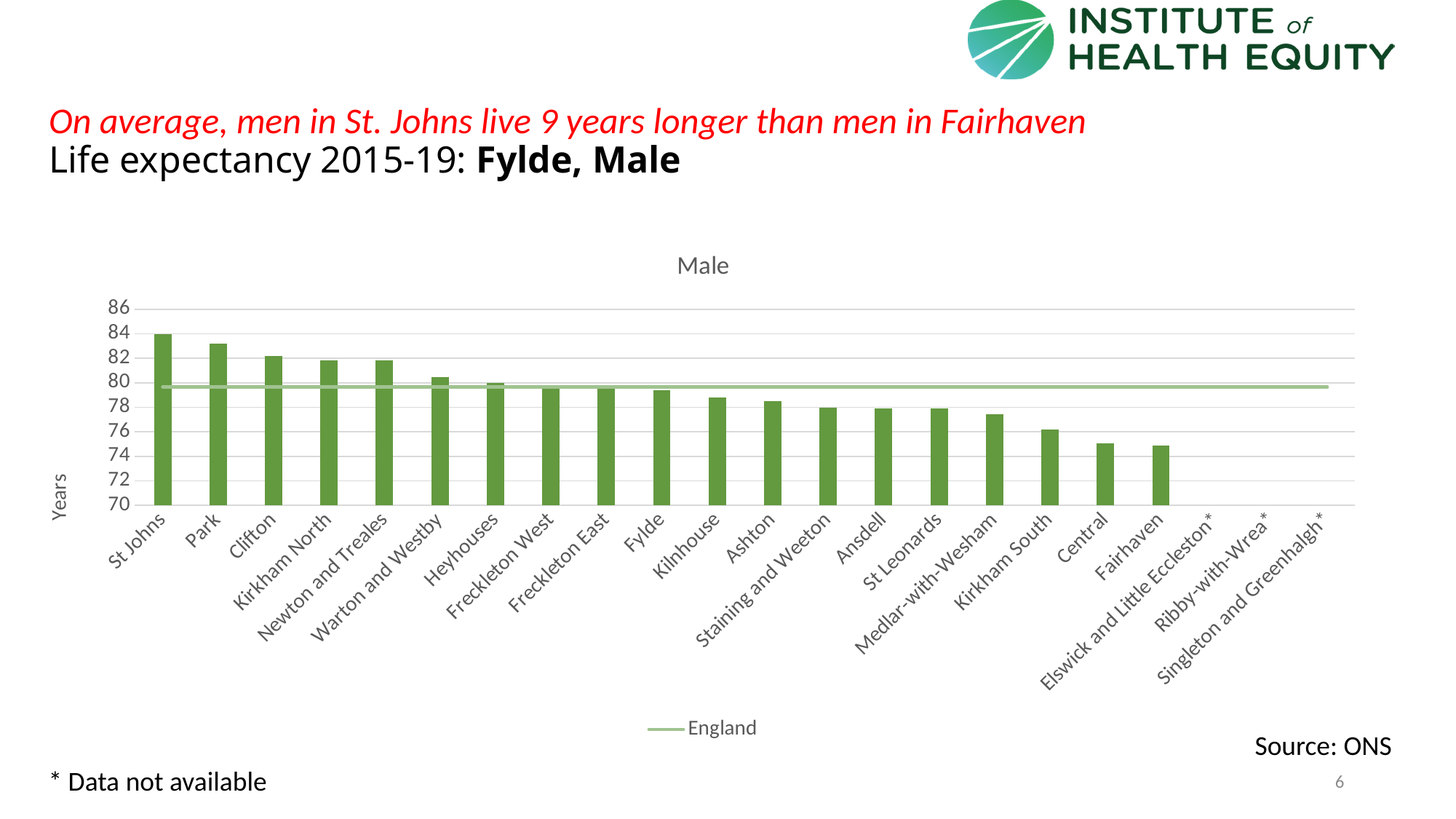
Is the value for Kilnhouse greater or less than 80? less Is the value for Fairhaven greater or less than 76? less Is the value for St Johns greater or less than 82? greater Which area has the highest male life expectancy in the chart? St Johns Which is larger, the value for Park or the value for Clifton? Park What kind of chart is shown on the slide? bar chart Do the bar values rise or fall moving from left to right along the x axis? fall Among the areas with a bar shown, which has the lowest male life expectancy? Fairhaven How many entries does the chart legend list? 1 What is the label on the vertical axis of the chart? Years How many areas are marked with an asterisk as having no data available? 3